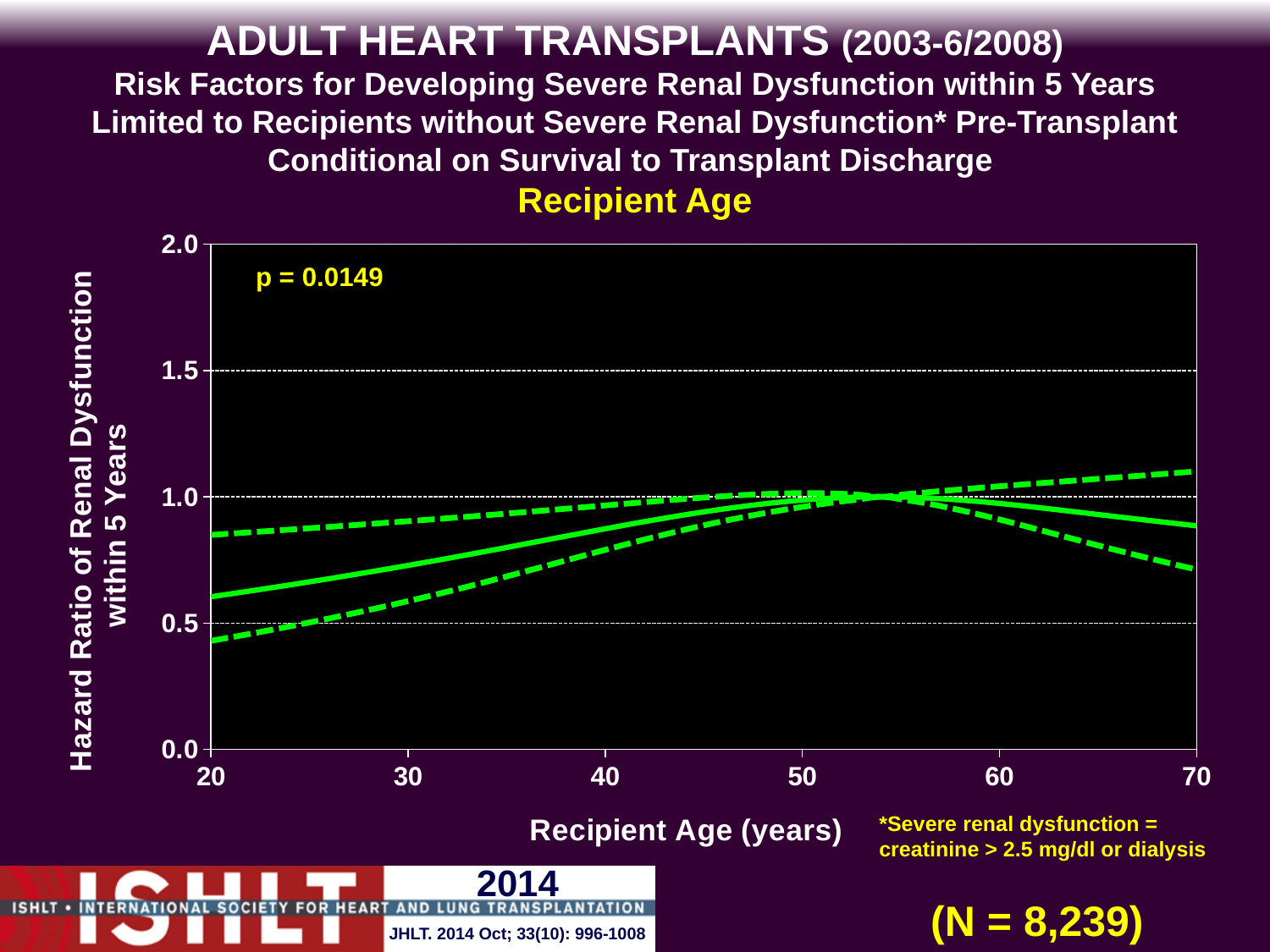
How many lines are plotted on the chart? 3 Is the value of the upper dashed line at recipient age 70 greater or less than 1.0? greater Is the value of the solid line at recipient age 70 greater or less than 1.0? less What kind of chart is shown on the slide? line chart How many tick labels are shown on the x axis? 6 Does the lower dashed line rise or fall as recipient age increases from 20 to 50 years? rise Does the solid line rise or fall as recipient age increases from 20 to 50 years? rise Is the value of the lower dashed line at recipient age 20 greater or less than 0.5? less What is the label of the x axis? Recipient Age (years) What is the p-value printed on the chart? p = 0.0149